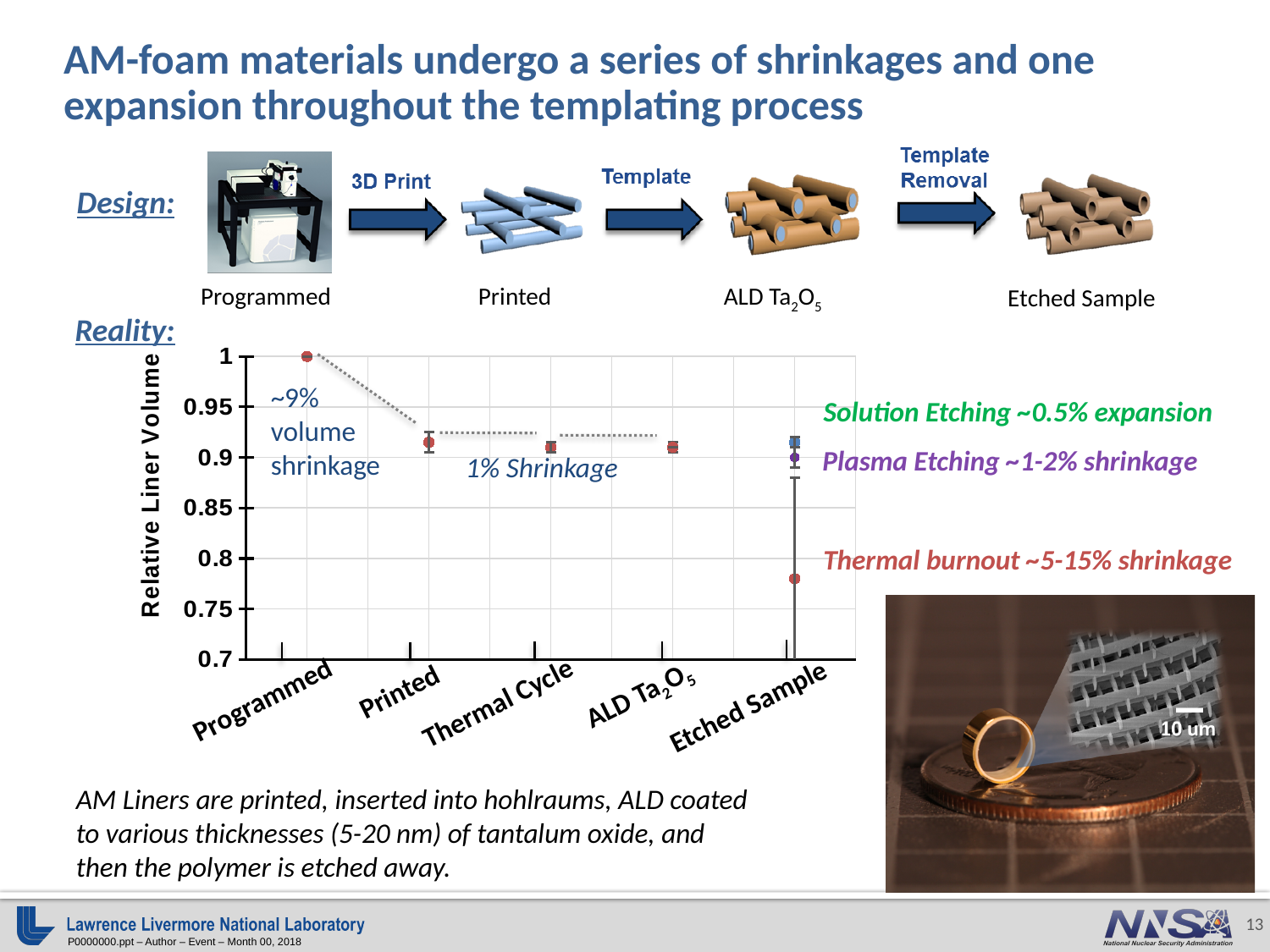
What is the title of the y axis of the chart? Relative Liner Volume Is the lowest plotted value for Etched Sample greater or less than 0.8? less Which has the larger relative liner volume, Programmed or Printed? Programmed What kind of chart is shown on the slide? scatter chart with error bars What is the relative liner volume for the Programmed category? 1 Is the relative liner volume for ALD Ta2O5 greater or less than 0.95? less Is the relative liner volume for Printed greater or less than 0.9? greater Which category contains the lowest plotted relative liner volume? Etched Sample Do the plotted values generally rise or fall from Programmed to Etched Sample? fall According to the annotation on the chart, what is the approximate volume shrinkage between Programmed and Printed? ~9% How many categories are shown on the x axis of the chart? 5 Which category has the highest relative liner volume? Programmed